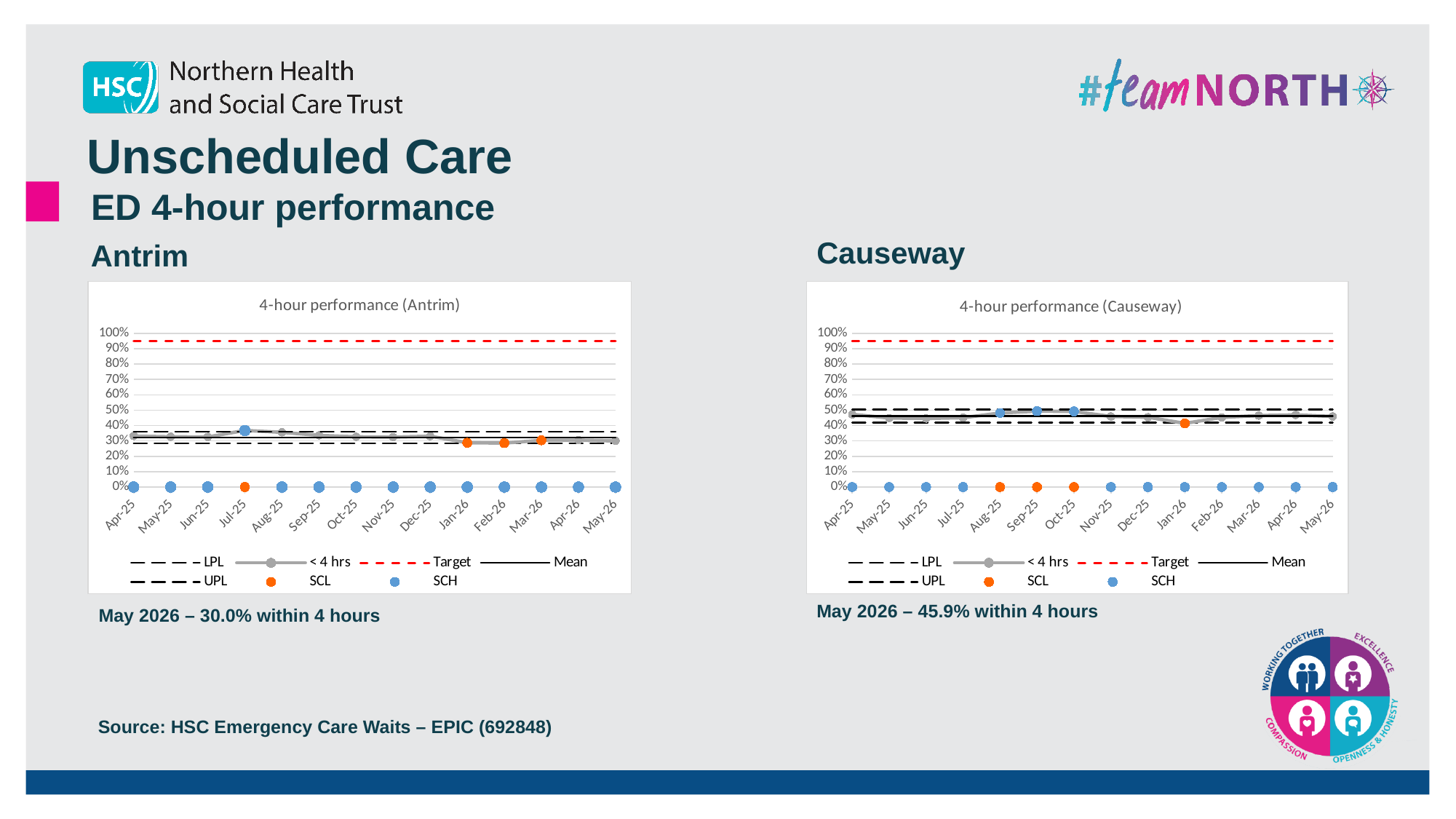
How many series does the legend of the 4-hour performance (Antrim) chart list? 7 What type of chart is the 4-hour performance (Antrim) chart? line chart How many months are plotted on the x axis of the 4-hour performance (Causeway) chart? 14 What is the difference between the Causeway and Antrim May 2026 4-hour performance figures? 15.9 percentage points On the 4-hour performance (Antrim) chart, is the < 4 hrs value for Jul-25 greater or less than 30%? greater On the 4-hour performance (Antrim) chart, what was the percentage seen within 4 hours in May 2026? 30.0% On the 4-hour performance (Causeway) chart, what colour is the Target line? red On the 4-hour performance (Causeway) chart, what was the percentage seen within 4 hours in May 2026? 45.9% Which site had the higher 4-hour performance in May 2026, Antrim or Causeway? Causeway On the 4-hour performance (Causeway) chart, is the < 4 hrs value for Sep-25 greater or less than 40%? greater On the 4-hour performance (Causeway) chart, which month has the lowest < 4 hrs value? Jan-26 On the 4-hour performance (Antrim) chart, does the < 4 hrs line rise or fall between Jul-25 and Jan-26? fall